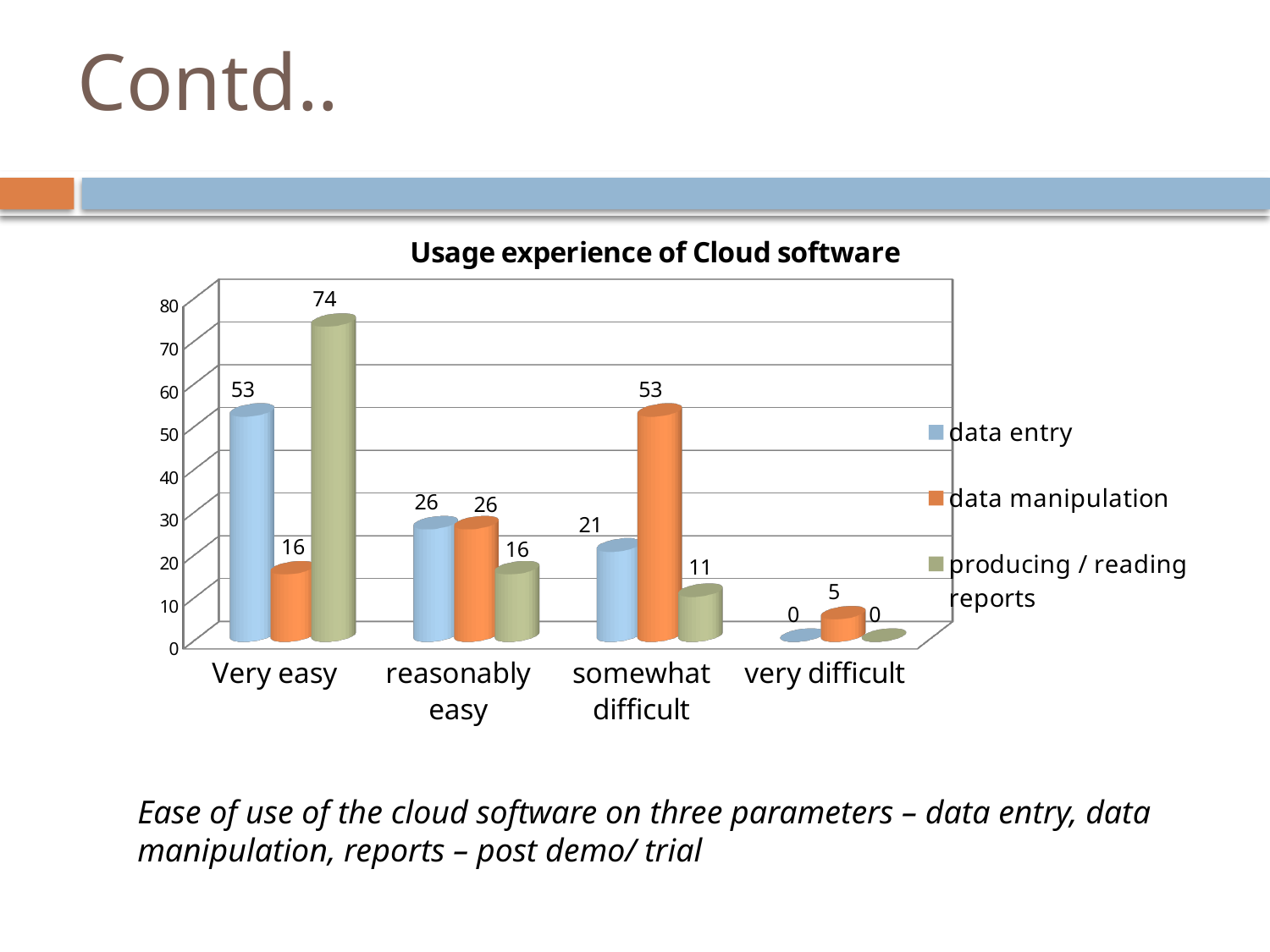
What is the value for producing / reading reports in the Very easy category? 74 What is the value for data manipulation in the very difficult category? 5 Which is larger in the somewhat difficult category: data entry or data manipulation? data manipulation Which series has the highest value in the Very easy category? producing / reading reports What is the title of the chart? Usage experience of Cloud software What kind of chart is shown on the slide? bar chart What is the value for data manipulation in the somewhat difficult category? 53 What is the difference between the producing / reading reports value and the data manipulation value in the Very easy category? 58 Which category has the lowest value for data entry? very difficult How many series does the legend list? 3 What is the value for data entry in the Very easy category? 53 How many categories are shown on the x axis? 4